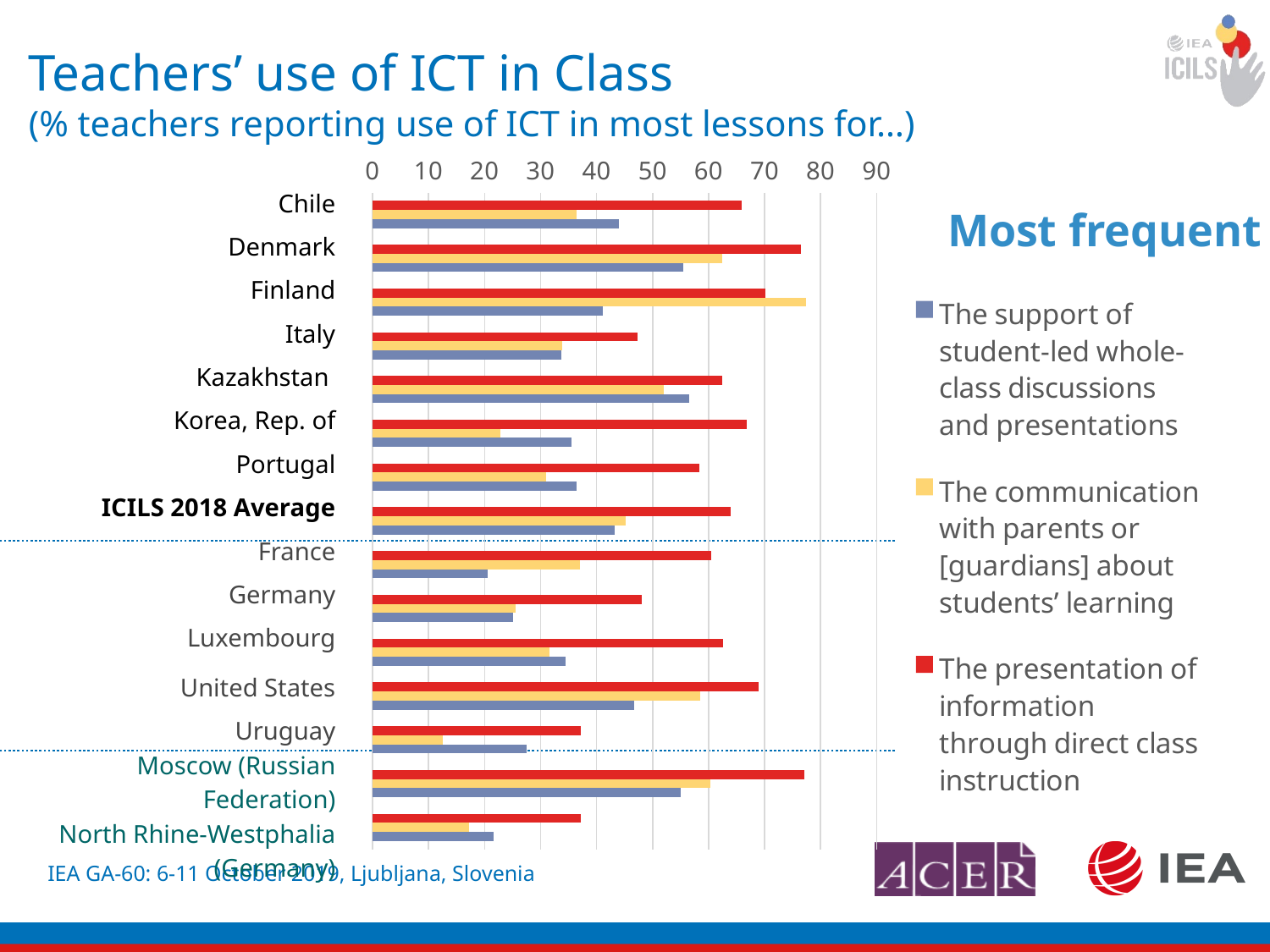
Is the value for France for 'The support of student-led whole-class discussions and presentations' greater or less than 30? less For Finland, which is larger: the value for 'The communication with parents or [guardians] about students' learning' or the value for 'The presentation of information through direct class instruction'? The communication with parents or [guardians] about students' learning For Korea, Rep. of, which is larger: the value for 'The presentation of information through direct class instruction' or the value for 'The communication with parents or [guardians] about students' learning'? The presentation of information through direct class instruction How many countries or education systems (including the ICILS 2018 Average) are plotted on the chart? 15 What is the title of the chart on the slide? Teachers' use of ICT in Class Which country has the lowest value for 'The communication with parents or [guardians] about students' learning'? Uruguay Which country has the highest value for 'The communication with parents or [guardians] about students' learning'? Finland Is the value for Finland for 'The communication with parents or [guardians] about students' learning' greater or less than 70? greater Is the value for Chile for 'The presentation of information through direct class instruction' greater or less than 60? greater What kind of chart is shown on the slide? bar chart How many series does the legend list? 3